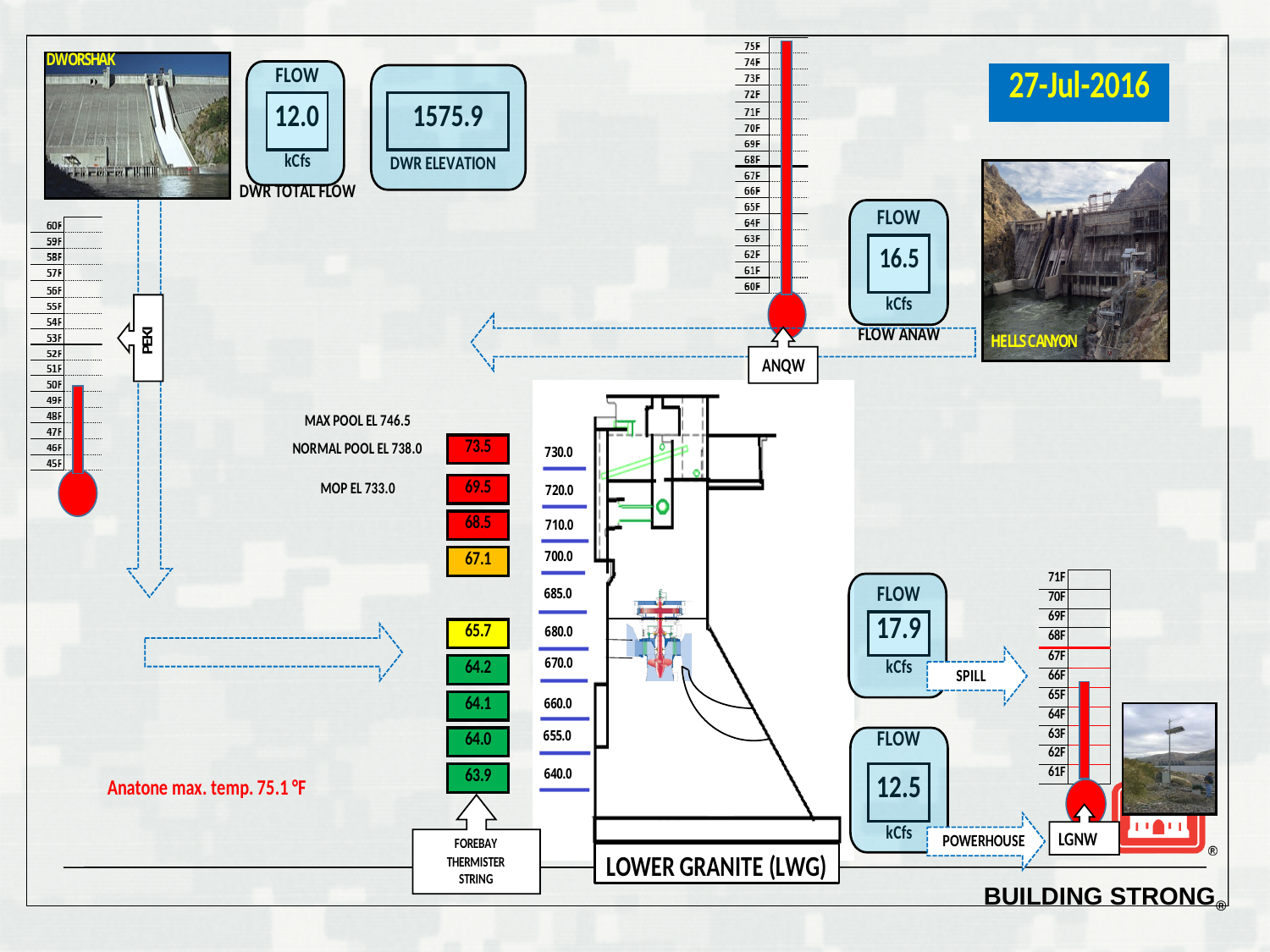
What is the DWR total flow value shown for Dworshak? 12.0 kCfs On the ANQW thermometer, is the reading greater or less than 65F? greater On the PEKI thermometer, is the reading greater or less than 55F? less What is the difference between the Lower Granite spill flow and powerhouse flow in kCfs? 5.4 What is the flow value shown for Hells Canyon (FLOW ANAW)? 16.5 kCfs What is the DWR elevation value shown on the slide? 1575.9 What is the powerhouse flow value shown for Lower Granite? 12.5 kCfs What is the highest temperature shown on the forebay thermister string? 73.5 How many temperature readings are shown on the forebay thermister string? 9 What is the spill flow value shown for Lower Granite? 17.9 kCfs Which is larger at Lower Granite, the spill flow or the powerhouse flow? Spill flow What is the lowest temperature shown on the forebay thermister string? 63.9